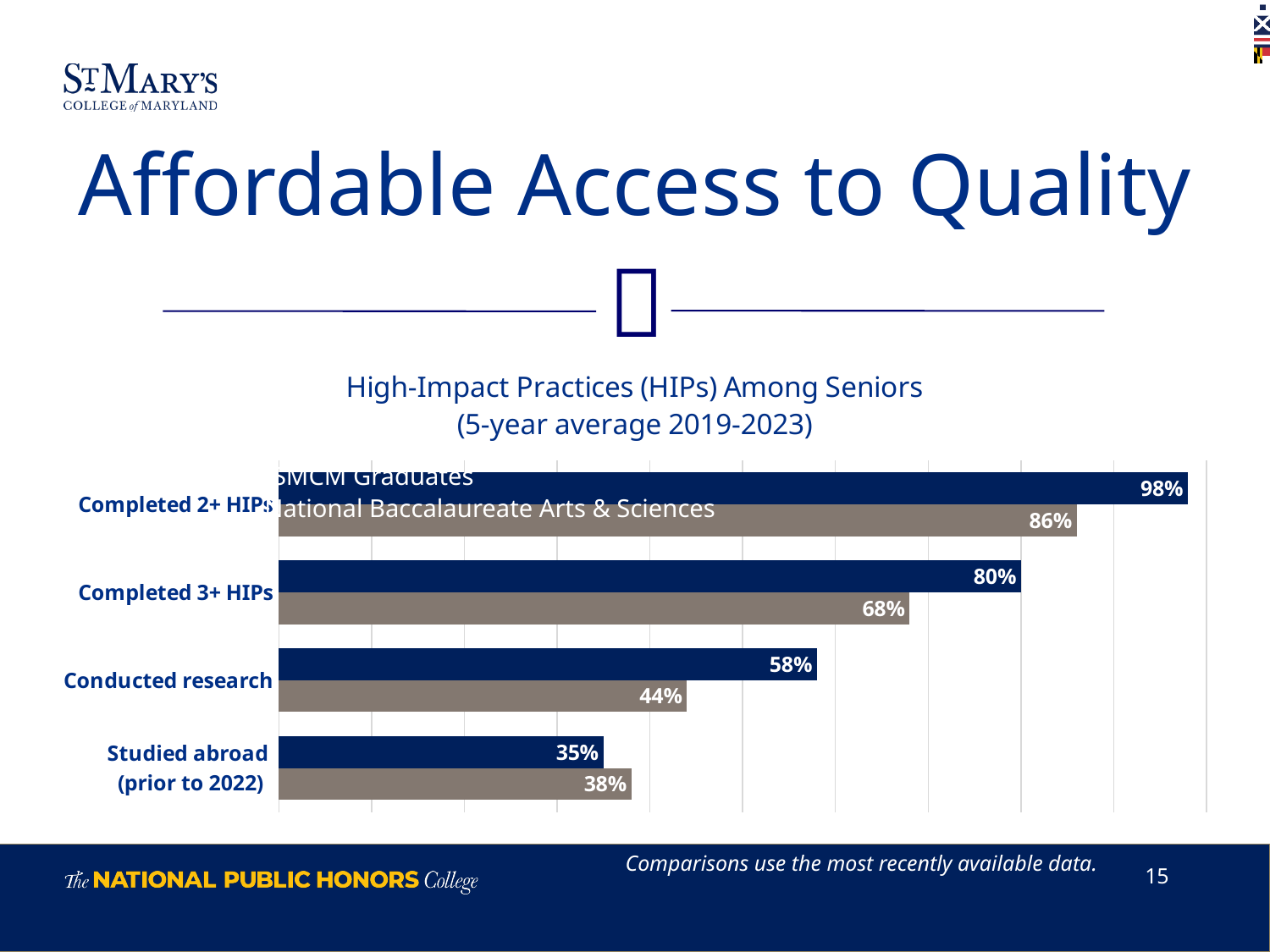
How many categories are shown in the chart? 4 What is the title of the chart? High-Impact Practices (HIPs) Among Seniors (5-year average 2019-2023) What is the National Baccalaureate Arts & Sciences value for Conducted research? 44% What kind of chart is shown on the slide? Bar chart Which category has the highest SMCM Graduates value? Completed 2+ HIPs For Studied abroad (prior to 2022), which series has the larger value: SMCM Graduates or National Baccalaureate Arts & Sciences? National Baccalaureate Arts & Sciences What is the National Baccalaureate Arts & Sciences value for Completed 3+ HIPs? 68% How many series does the legend list? 2 What is the SMCM Graduates value for Completed 2+ HIPs? 98% What is the difference between the SMCM Graduates and National Baccalaureate Arts & Sciences values for Conducted research? 14% What is the SMCM Graduates value for Studied abroad (prior to 2022)? 35% Which category has the lowest National Baccalaureate Arts & Sciences value? Studied abroad (prior to 2022)